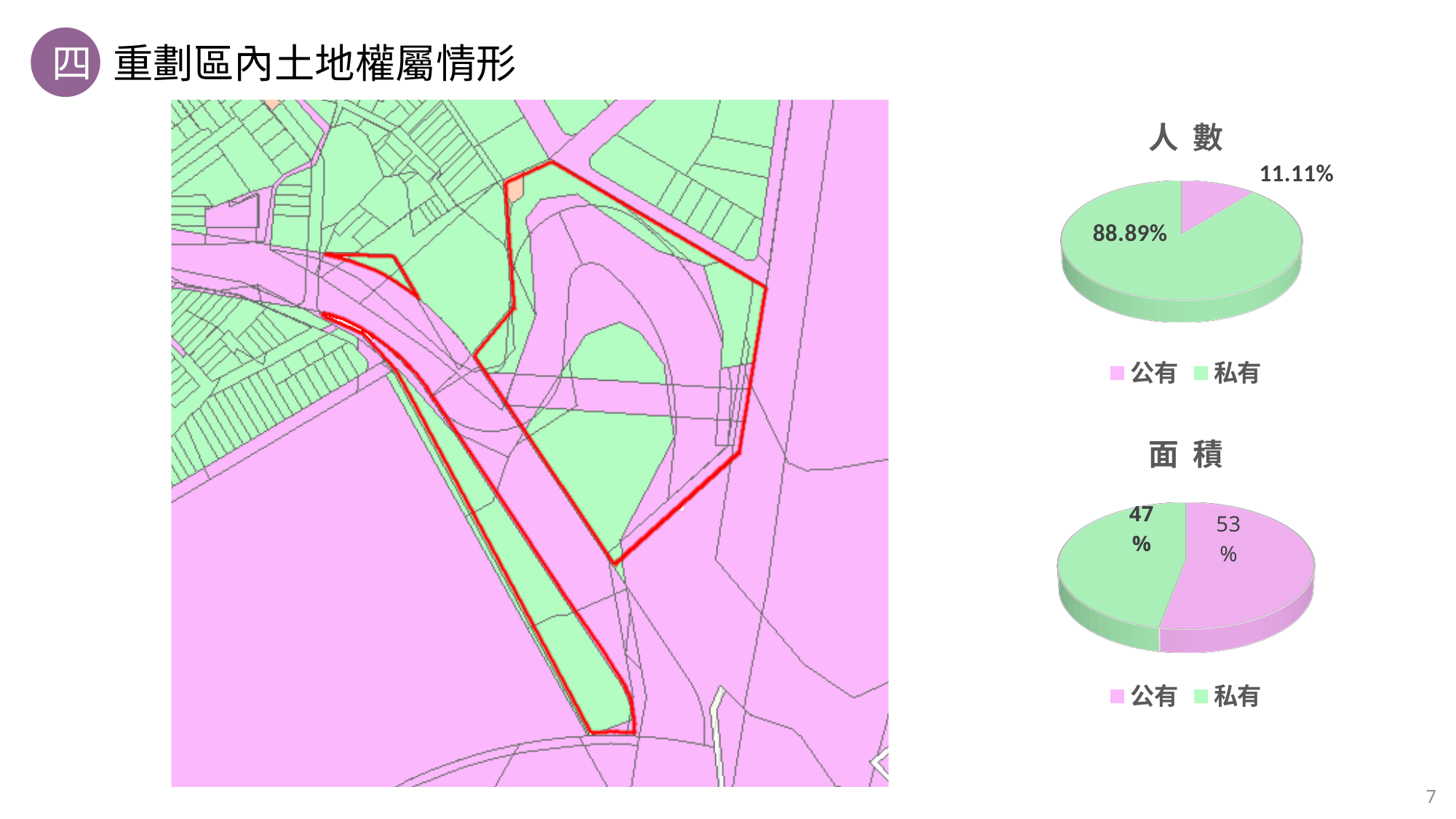
In the 人數 pie chart, which colour represents 公有? Pink How many categories does the legend of the 人數 pie chart list? 2 What type of chart is the 面積 chart? Pie chart In the 面積 pie chart, what share does 公有 have? 53% In the 面積 pie chart, which is larger, 公有 or 私有? 公有 In the 人數 pie chart, what share does 公有 have? 11.11% In the 人數 pie chart, what share does 私有 have? 88.89% In the 人數 pie chart, what is the difference between the 私有 and 公有 shares? 77.78% In the 面積 pie chart, what is the difference between the 公有 and 私有 shares? 6% In the 面積 pie chart, which category has the smallest slice? 私有 In the 面積 pie chart, what share does 私有 have? 47% In the 人數 pie chart, which category has the largest slice? 私有